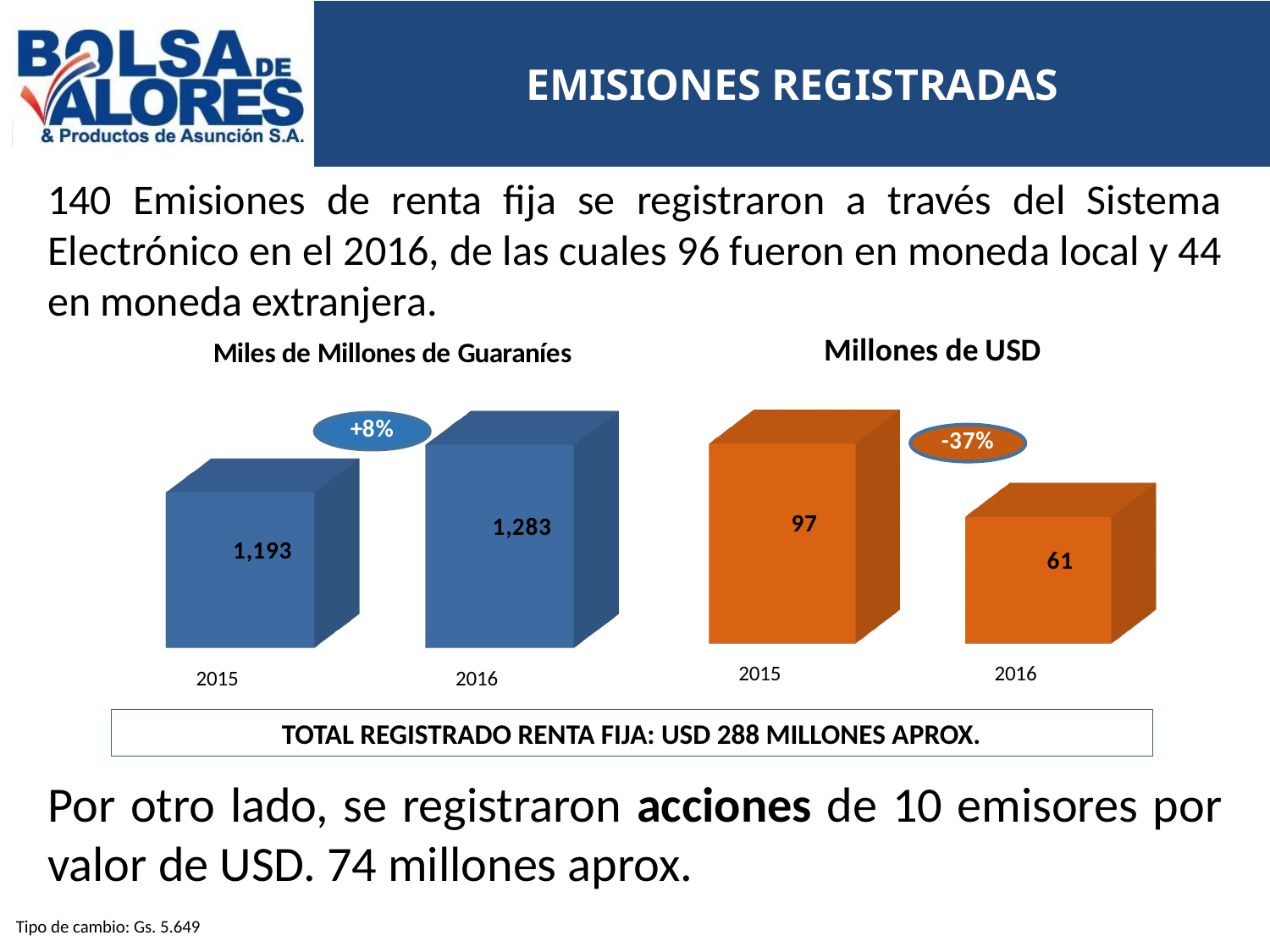
In the 'Miles de Millones de Guaraníes' chart, what is the difference between the 2016 and 2015 values? 90 How many categories does the 'Miles de Millones de Guaraníes' chart show? 2 In the 'Millones de USD' chart, what is the value for 2016? 61 What kind of chart is the 'Millones de USD' chart? bar chart In the 'Millones de USD' chart, what is the value for 2015? 97 In the 'Millones de USD' chart, which year has the lower value? 2016 In the 'Millones de USD' chart, is the value for 2015 larger or smaller than the value for 2016? larger In the 'Miles de Millones de Guaraníes' chart, what is the value for 2016? 1,283 In the 'Miles de Millones de Guaraníes' chart, which year has the higher value? 2016 In the 'Miles de Millones de Guaraníes' chart, what is the value for 2015? 1,193 In the 'Millones de USD' chart, what is the difference between the 2015 and 2016 values? 36 In the 'Millones de USD' chart, do the values rise or fall from 2015 to 2016? fall